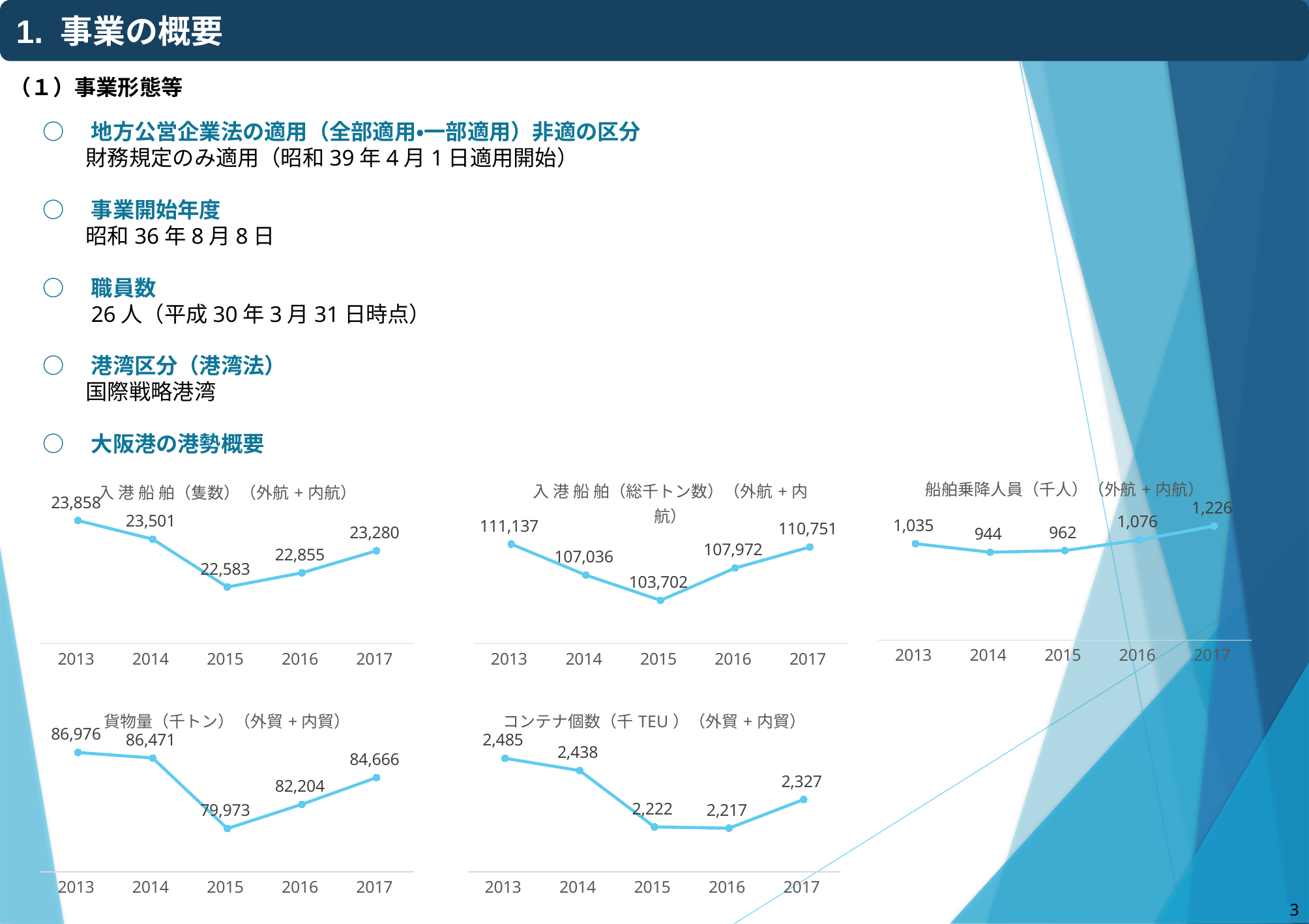
What type of chart is the chart titled 貨物量（千トン）（外貿＋内貿）? Line chart In the chart titled 船舶乗降人員（千人）（外航＋内航）, what is the value for 2016? 1,076 In the chart titled 入港船舶（総千トン数）（外航＋内航）, what is the value for 2017? 110,751 In the chart titled 入港船舶（総千トン数）（外航＋内航）, what is the difference between the 2013 and 2015 values? 7,435 In the chart titled 貨物量（千トン）（外貿＋内貿）, which is larger, the value for 2013 or the value for 2017? 2013 In the chart titled 船舶乗降人員（千人）（外航＋内航）, which year has the highest value? 2017 In the chart titled 入港船舶（隻数）（外航＋内航）, what is the value for 2015? 22,583 In the chart titled コンテナ個数（千TEU）（外貿＋内貿）, what is the value for 2014? 2,438 In the chart titled 入港船舶（総千トン数）（外航＋内航）, which year has the lowest value? 2015 In the chart titled 貨物量（千トン）（外貿＋内貿）, what is the value for 2015? 79,973 In the chart titled コンテナ個数（千TEU）（外貿＋内貿）, how many years are plotted? 5 In the chart titled 入港船舶（隻数）（外航＋内航）, which year has the highest value? 2013